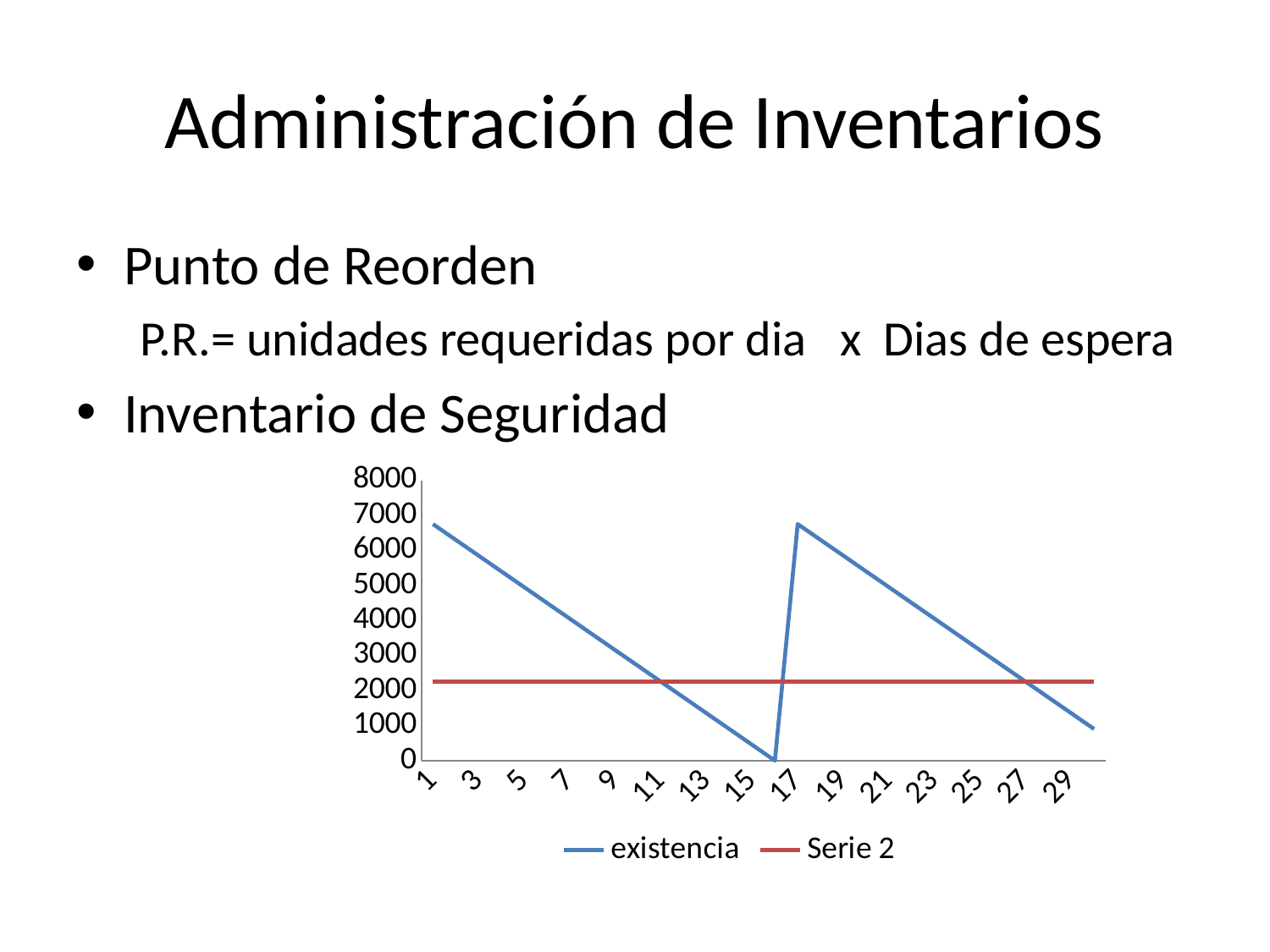
Is the value of existencia at x = 29 greater or less than 2000? less What is the highest value shown on the y axis? 8000 Is the value of Serie 2 greater or less than 3000? less Is the value of Serie 2 greater or less than 1000? greater Does the existencia series rise or fall between x = 1 and x = 15? fall What kind of chart is shown on the slide? line chart What are the two series named in the chart legend? existencia and Serie 2 How many series does the chart legend list? 2 Which series stays flat across the whole x axis? Serie 2 Which colour is used for the existencia series? blue